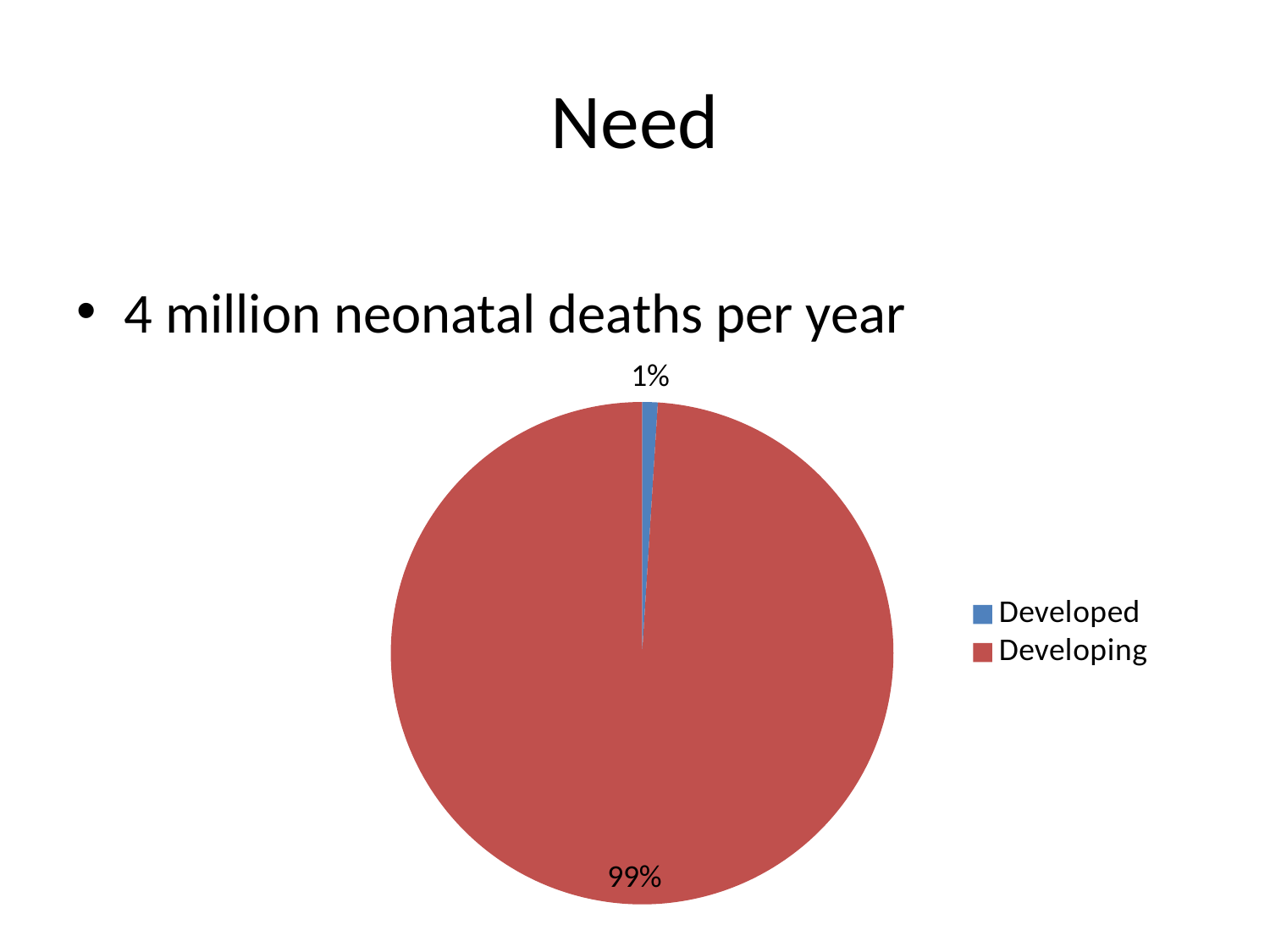
What colour is the Developed slice? blue What kind of chart is shown on the slide? pie chart What share of the pie does the Developing slice represent? 99% What share of the pie does the Developed slice represent? 1% How many categories does the pie chart show? 2 What is the difference in percentage points between the Developing and Developed slices? 98 Which category has the smallest slice of the pie? Developed Which slice is larger, Developed or Developing? Developing What colour is the Developing slice? red How many entries does the legend list? 2 Which category has the largest slice of the pie? Developing